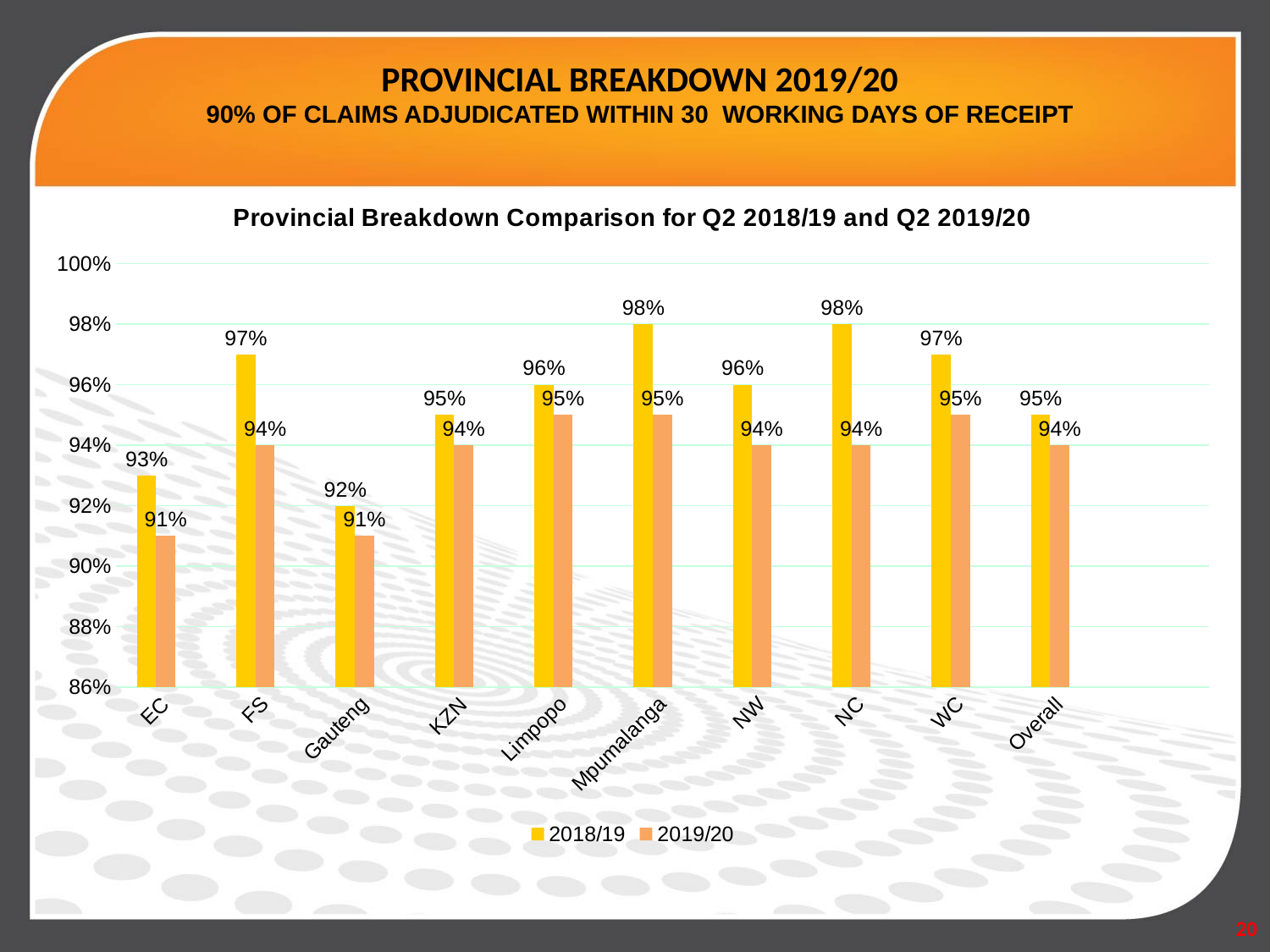
What is the difference between the 2018/19 values for Mpumalanga and EC? 5% What is the 2018/19 value for WC? 97% How many series does the legend list? 2 What is the difference between the 2018/19 and 2019/20 values for NC? 4% How many categories are shown on the x axis? 10 Which is larger for FS: the 2018/19 value or the 2019/20 value? 2018/19 What kind of chart is shown? bar chart Which category has the lowest 2018/19 value? Gauteng What is the 2018/19 value for EC? 93% What is the 2019/20 value for Gauteng? 91% What is the title of the chart? Provincial Breakdown Comparison for Q2 2018/19 and Q2 2019/20 What is the 2019/20 value for Overall? 94%